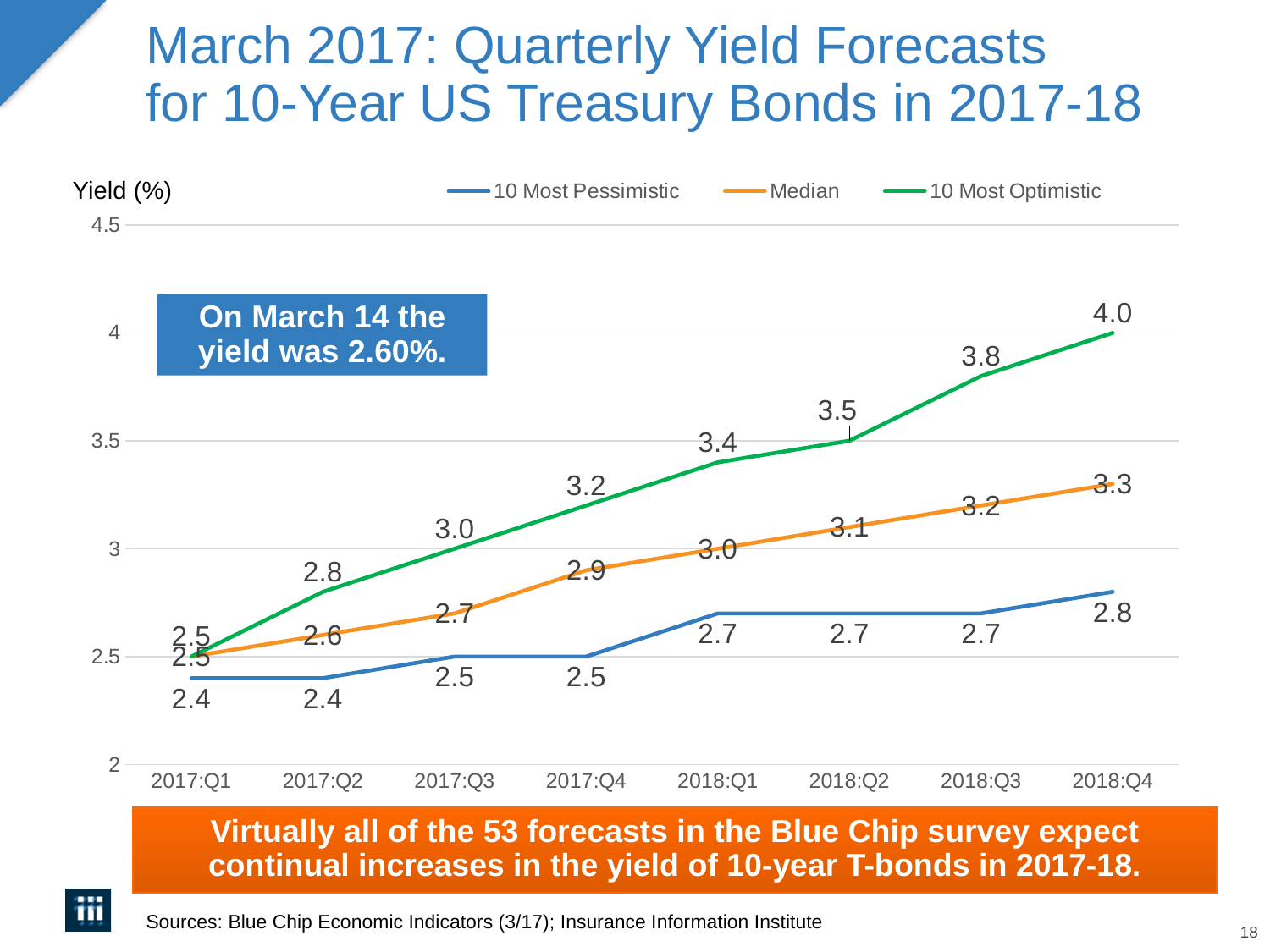
What is the 10 Most Optimistic forecast for 2018:Q4? 4.0 In which quarter does the 10 Most Optimistic series reach its highest value? 2018:Q4 Does the Median series rise or fall from 2017:Q1 to 2018:Q4? Rise What is the Median forecast for 2017:Q4? 2.9 How many series does the legend list? 3 Which is larger in 2018:Q2, the Median forecast or the 10 Most Pessimistic forecast? Median What kind of chart is shown on the slide? Line chart What is the 10 Most Pessimistic forecast for 2017:Q1? 2.4 Is the 10 Most Optimistic value for 2018:Q3 greater or less than 3.5? greater How many quarters are plotted along the x axis? 8 What is the difference between the 10 Most Optimistic and 10 Most Pessimistic forecasts for 2018:Q4? 1.2 According to the text box on the chart, what was the yield on March 14? 2.60%